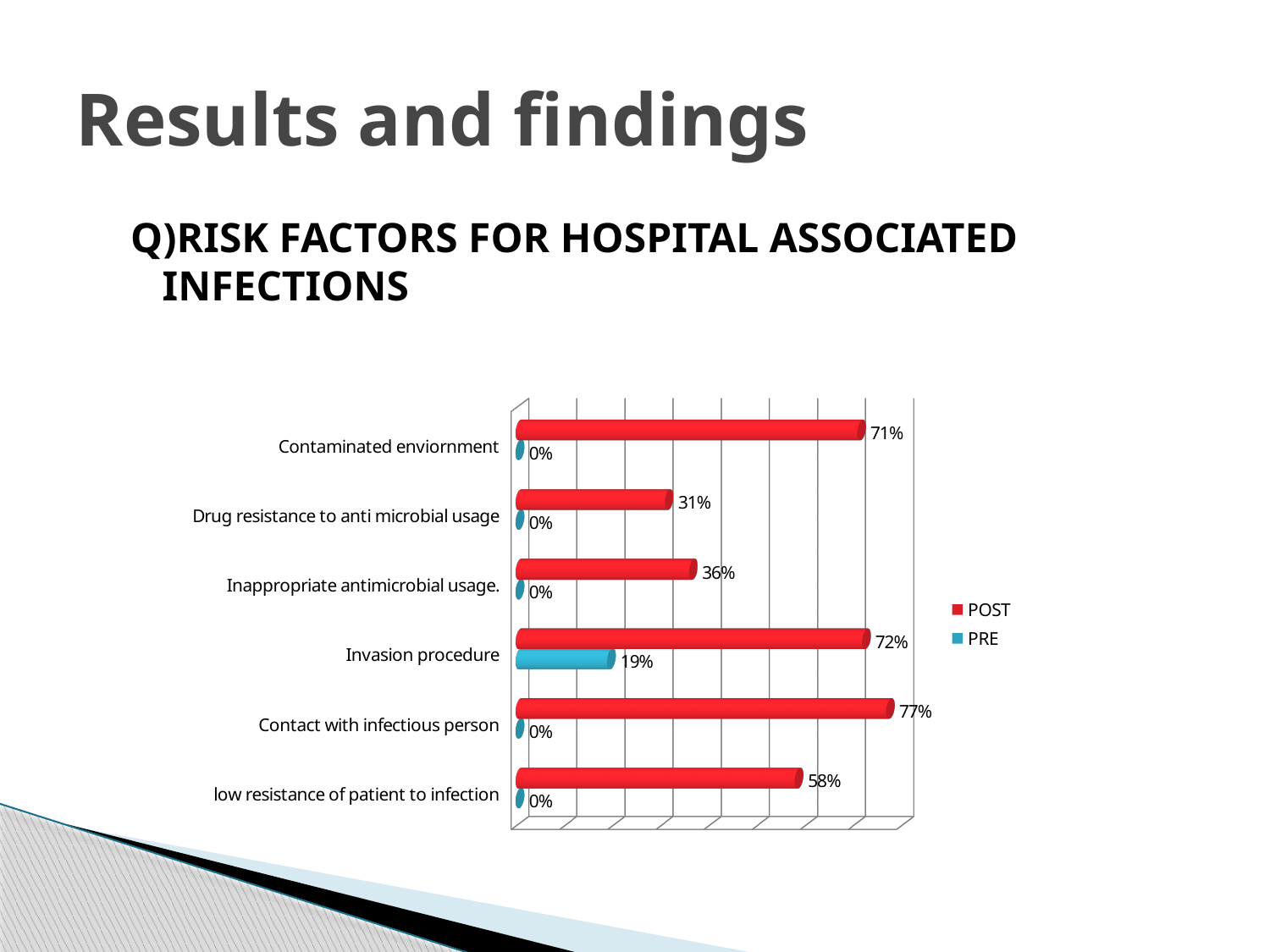
What is the POST value for Drug resistance to anti microbial usage? 31% Which is larger, the POST value for Inappropriate antimicrobial usage. or the POST value for low resistance of patient to infection? low resistance of patient to infection What colour are the POST bars? red What is the difference between the POST and PRE values for Invasion procedure? 53% Which category is the only one with a non-zero PRE value? Invasion procedure Which category has the highest POST value? Contact with infectious person What is the PRE value for Invasion procedure? 19% What is the POST value for Contaminated enviornment? 71% What kind of chart is shown on the slide? bar chart Which category has the lowest POST value? Drug resistance to anti microbial usage How many series does the legend list? 2 How many categories are shown on the chart? 6